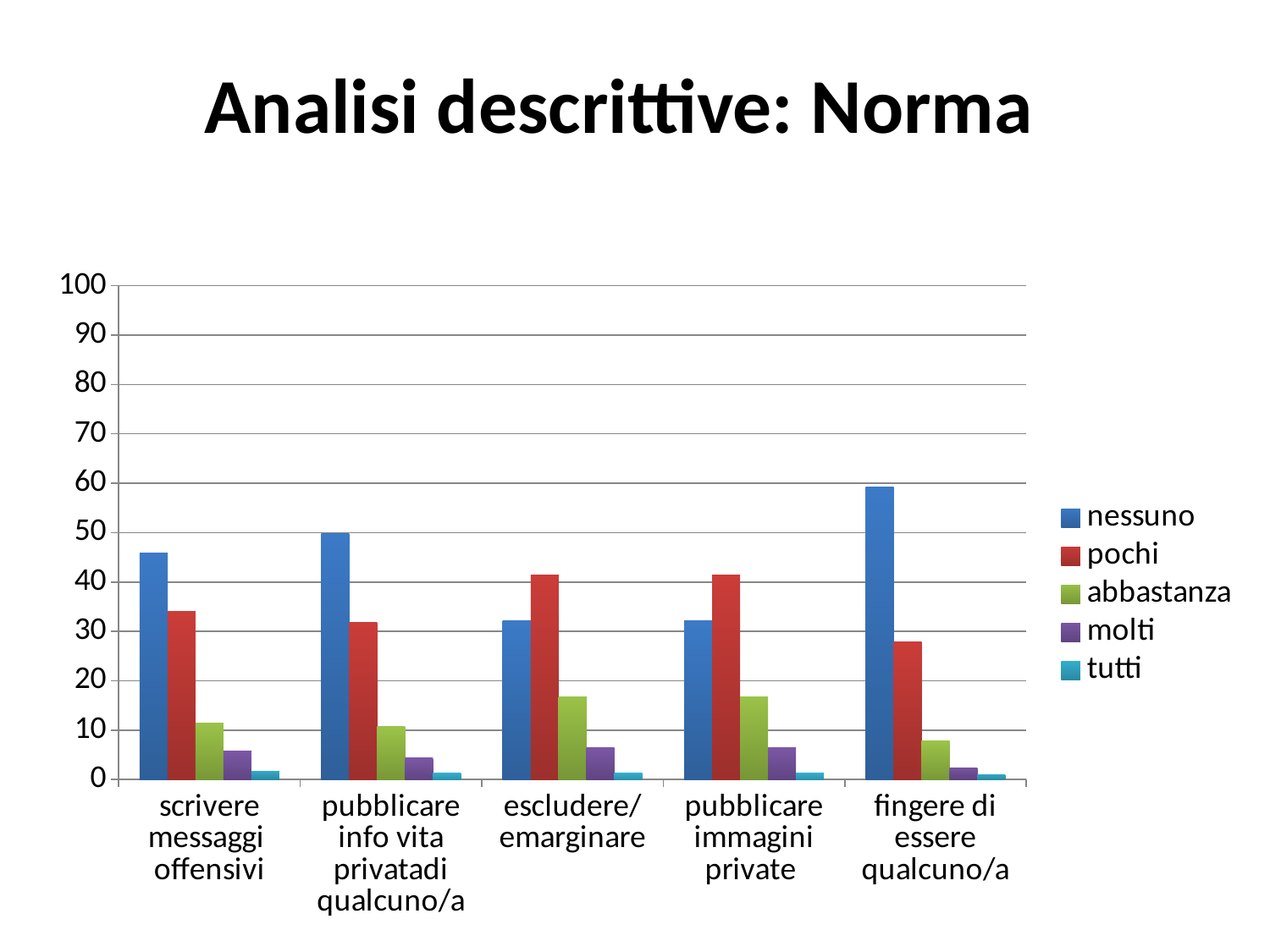
For 'escludere/emarginare', which is larger: 'nessuno' or 'pochi'? pochi How many series does the legend list? 5 Is the 'nessuno' value for 'pubblicare info vita privatadi qualcuno/a' greater or less than 40? greater Is the 'nessuno' value for 'fingere di essere qualcuno/a' greater or less than 50? greater Which category has the highest 'nessuno' bar? fingere di essere qualcuno/a For 'scrivere messaggi offensivi', which is larger: 'nessuno' or 'pochi'? nessuno Is the 'abbastanza' value for 'escludere/emarginare' greater or less than 20? less How many categories are shown on the x axis? 5 What is the title of the slide? Analisi descrittive: Norma Which series has the lowest bars in every category? tutti What kind of chart is shown on the slide? bar chart